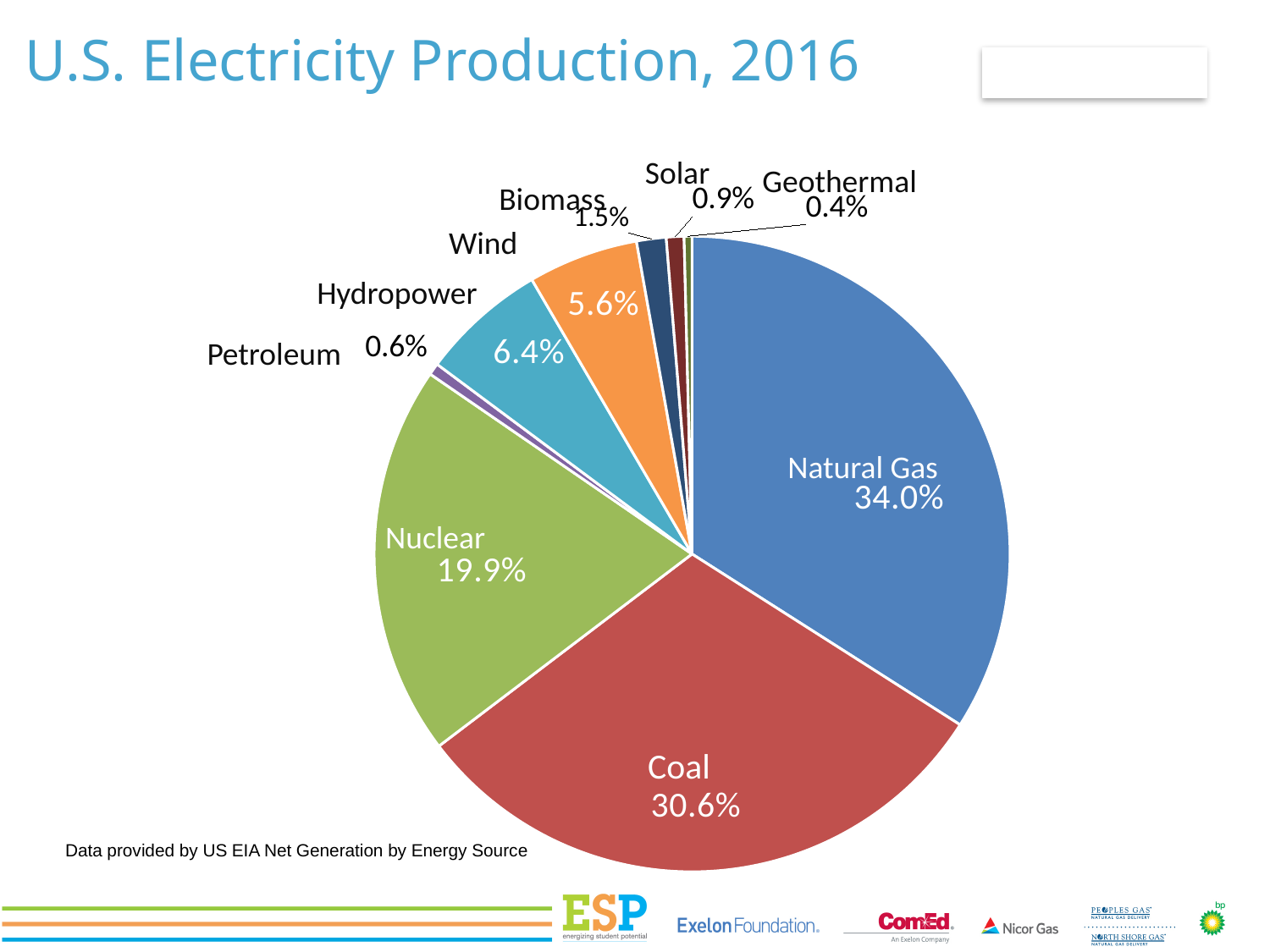
What kind of chart is shown on the slide? pie chart What share of U.S. electricity production in 2016 came from Natural Gas? 34.0% How many percentage points larger is the Natural Gas share than the Coal share? 3.4 percentage points What is the value shown for Geothermal? 0.4% Which energy source has the smallest slice of the pie? Geothermal What percentage of the pie is Coal? 30.6% What is the value shown for Nuclear? 19.9% What is the value shown for Wind? 5.6% Which is larger, the share for Hydropower or the share for Wind? Hydropower Which energy source has the largest slice of the pie? Natural Gas How many energy sources are shown in the pie chart? 9 What is the value shown for Hydropower? 6.4%